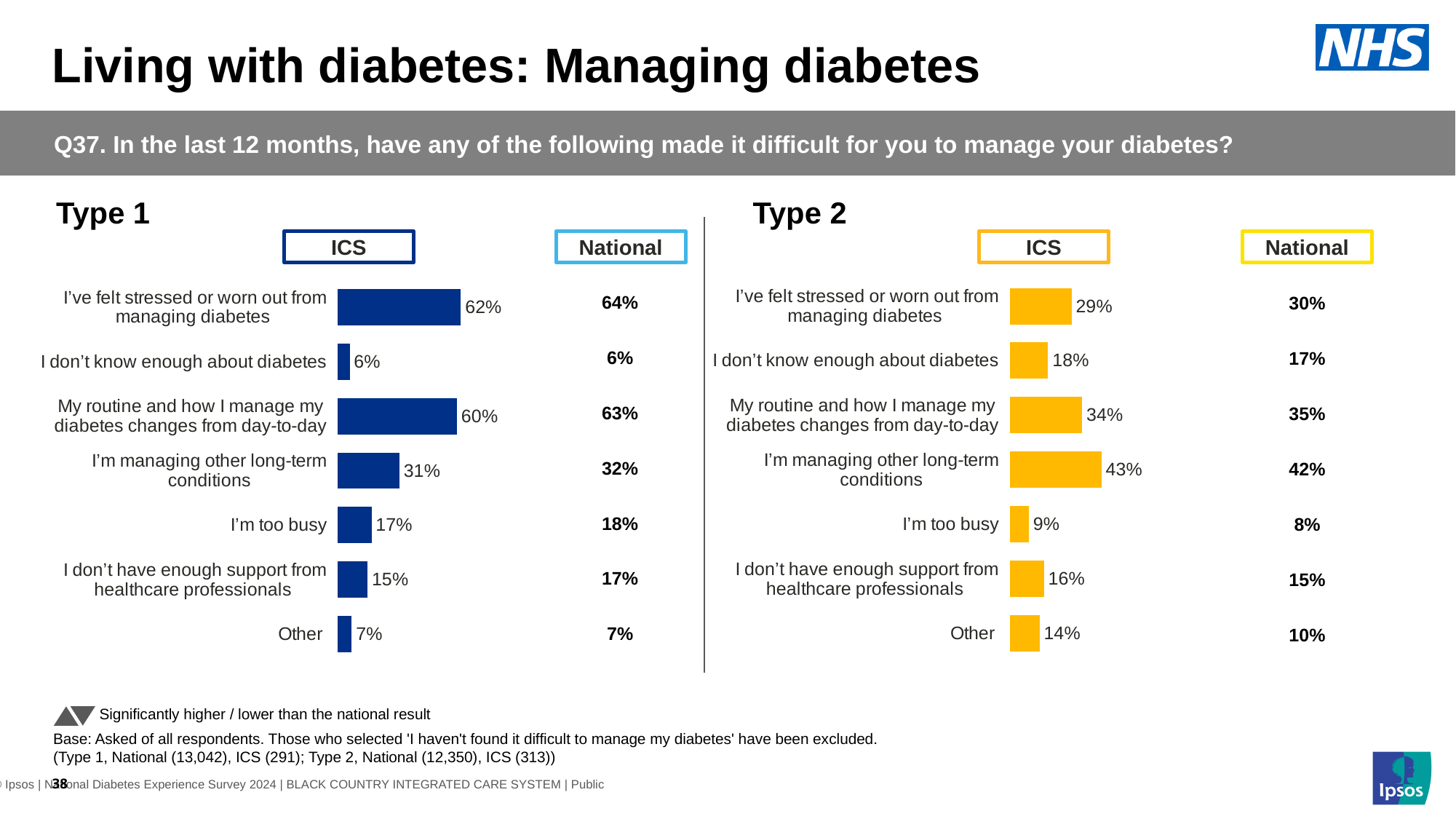
In the Type 2 chart, is the ICS value for 'I don't know enough about diabetes' larger or smaller than the National value? larger In the Type 2 chart, what is the difference between the ICS and National values for 'Other'? 4 percentage points In the Type 1 chart, what is the ICS value for 'I've felt stressed or worn out from managing diabetes'? 62% What colour are the ICS bars in the Type 2 chart? yellow/orange In the Type 1 chart, what is the National value for 'I'm too busy'? 18% What type of chart is used for the ICS values in the Type 1 section? bar chart In the Type 2 chart, what is the ICS value for 'I'm managing other long-term conditions'? 43% In the Type 2 chart, what is the National value for 'Other'? 10% In the Type 2 chart, which category has the lowest ICS value? I'm too busy In the Type 1 chart, which category has the highest ICS value? I've felt stressed or worn out from managing diabetes In the Type 1 chart, how many categories are shown? 7 In the Type 1 chart, what is the difference between the ICS and National values for 'My routine and how I manage my diabetes changes from day-to-day'? 3 percentage points